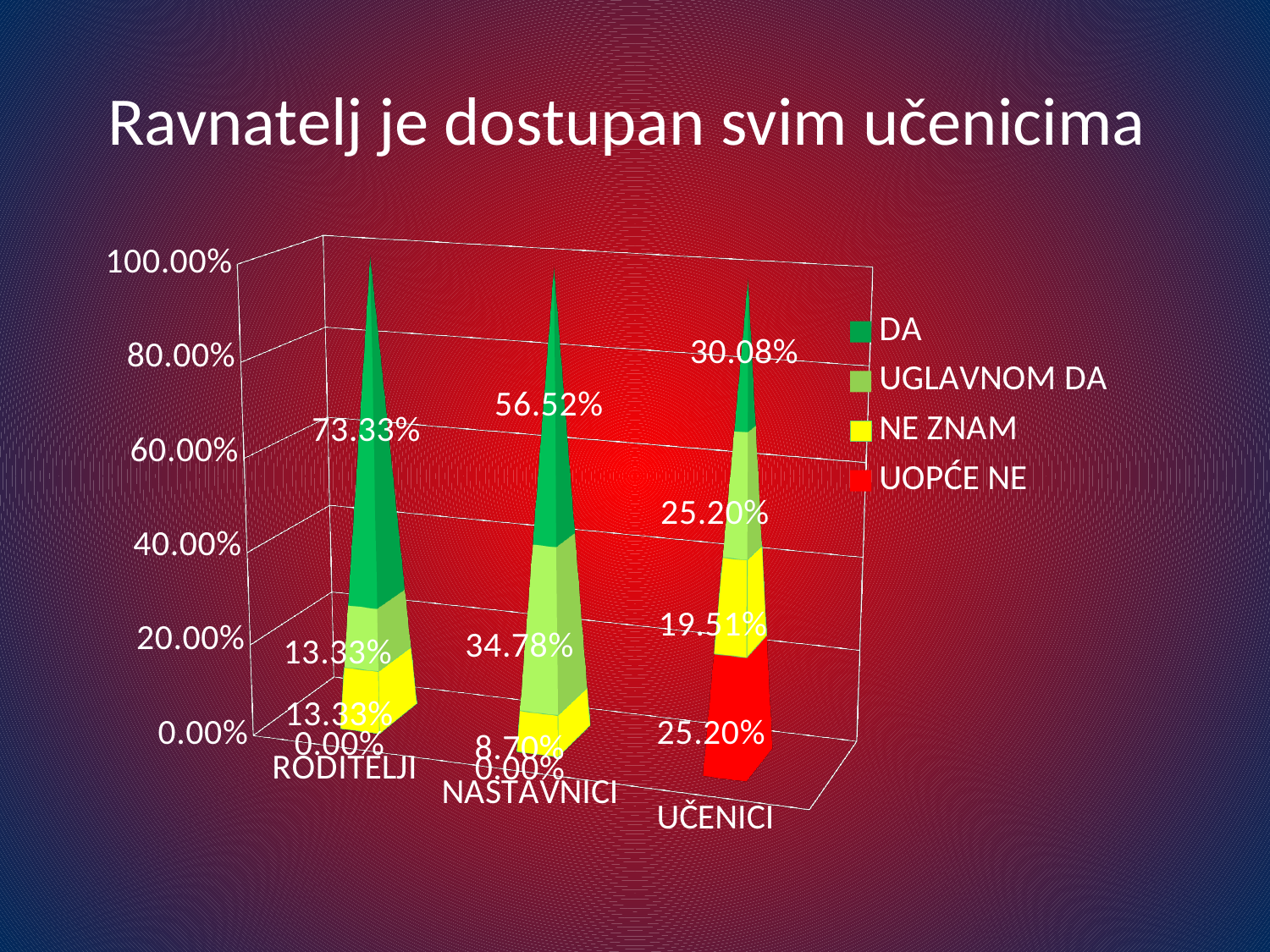
What is the UOPĆE NE value for UČENICI? 25.20% Which category has the lowest DA value? UČENICI What is the NE ZNAM value for NASTAVNICI? 8.70% What is the DA value for RODITELJI? 73.33% What is the DA value for NASTAVNICI? 56.52% What is the title of the slide? Ravnatelj je dostupan svim učenicima Which is larger, the UGLAVNOM DA value for NASTAVNICI or for UČENICI? NASTAVNICI Which category has the highest DA value? RODITELJI How many categories are shown on the x axis? 3 How many series does the legend list? 4 What kind of chart is shown on the slide? stacked bar chart What is the difference between the DA values for RODITELJI and NASTAVNICI? 16.81%